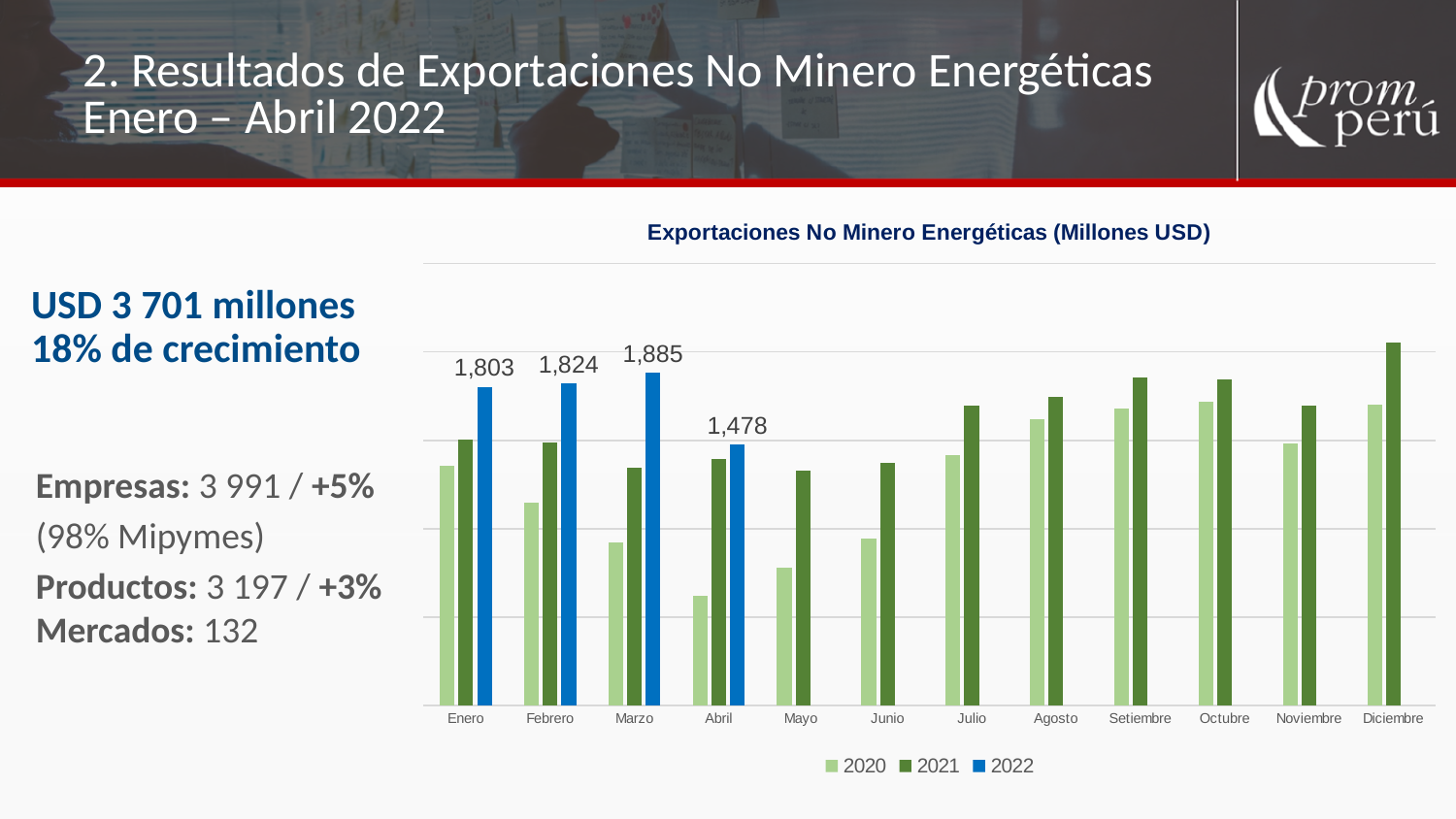
Which month has the lowest 2022 value among those plotted? Abril What is the difference between the 2022 values for Marzo and Abril? 407 How many months are shown on the x axis? 12 Which is larger, the 2022 value for Enero or for Febrero? Febrero How many series does the legend list? 3 Which month has the lowest 2020 value? Abril What kind of chart is shown? Bar chart What is the 2022 value for Marzo? 1,885 What is the 2022 value for Enero in the chart? 1,803 What is the 2022 value for Abril? 1,478 Which month has the highest 2022 value? Marzo Which month has the highest 2021 value? Diciembre